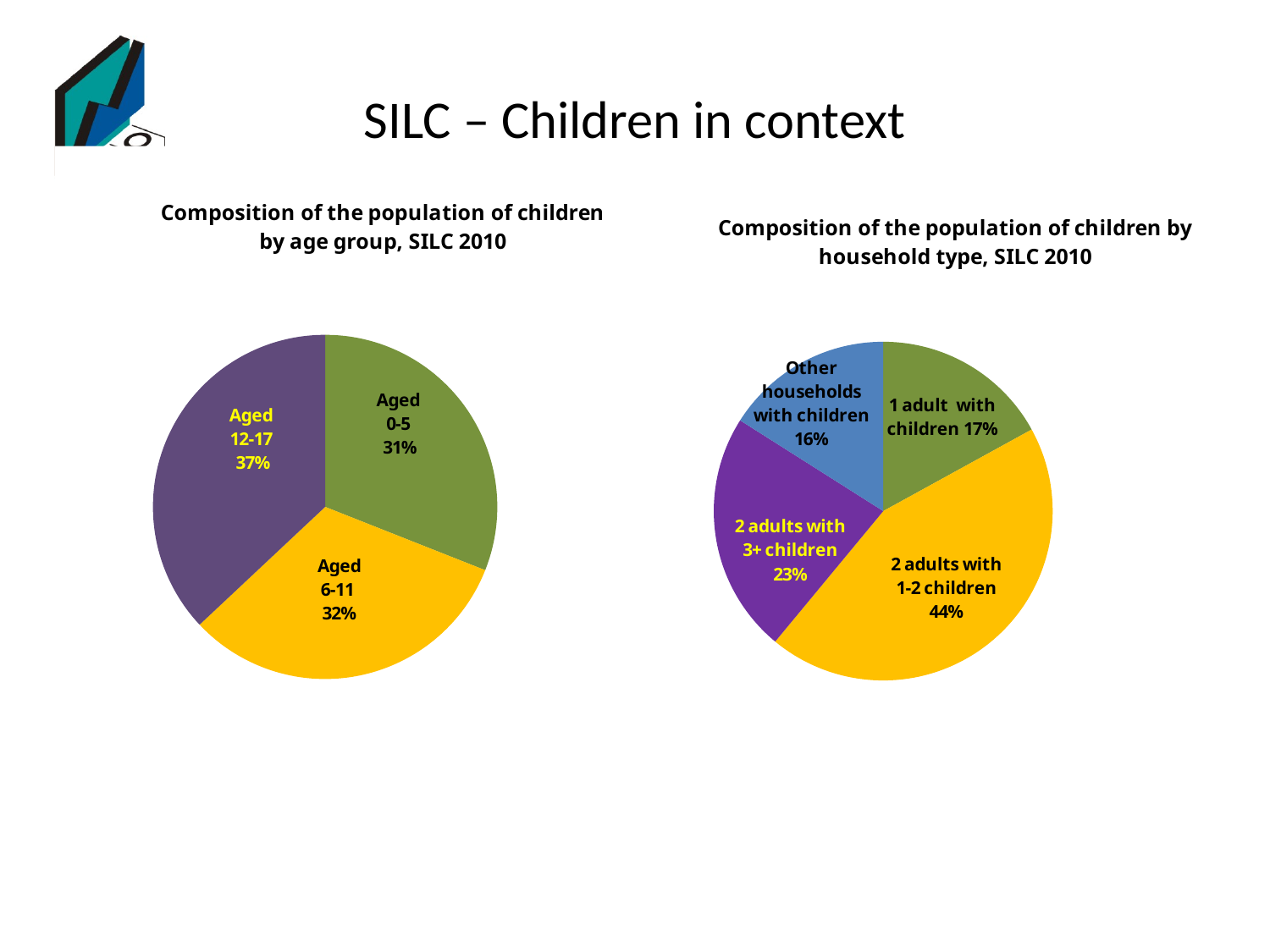
In the right chart (Composition of the population of children by household type, SILC 2010), what share of children live in households with 2 adults with 1-2 children? 44% In the left chart (by age group), how many age groups are shown? 3 In the right chart (by household type), which household type has the smallest share? Other households with children In the right chart (by household type), which household type has the largest share? 2 adults with 1-2 children In the left chart (Composition of the population of children by age group, SILC 2010), what share of children are aged 12-17? 37% In the left chart (by age group), what share of children are aged 0-5? 31% In the right chart (by household type), what share of children live in other households with children? 16% In the left chart (by age group), what is the difference in percentage points between the Aged 12-17 and Aged 6-11 shares? 5 percentage points In the left chart (by age group), which age group has the largest share? Aged 12-17 What type of chart is used on the right side of the slide? Pie chart In the right chart (by household type), how many household types are shown? 4 In the left chart (by age group), which age group has the smallest share? Aged 0-5